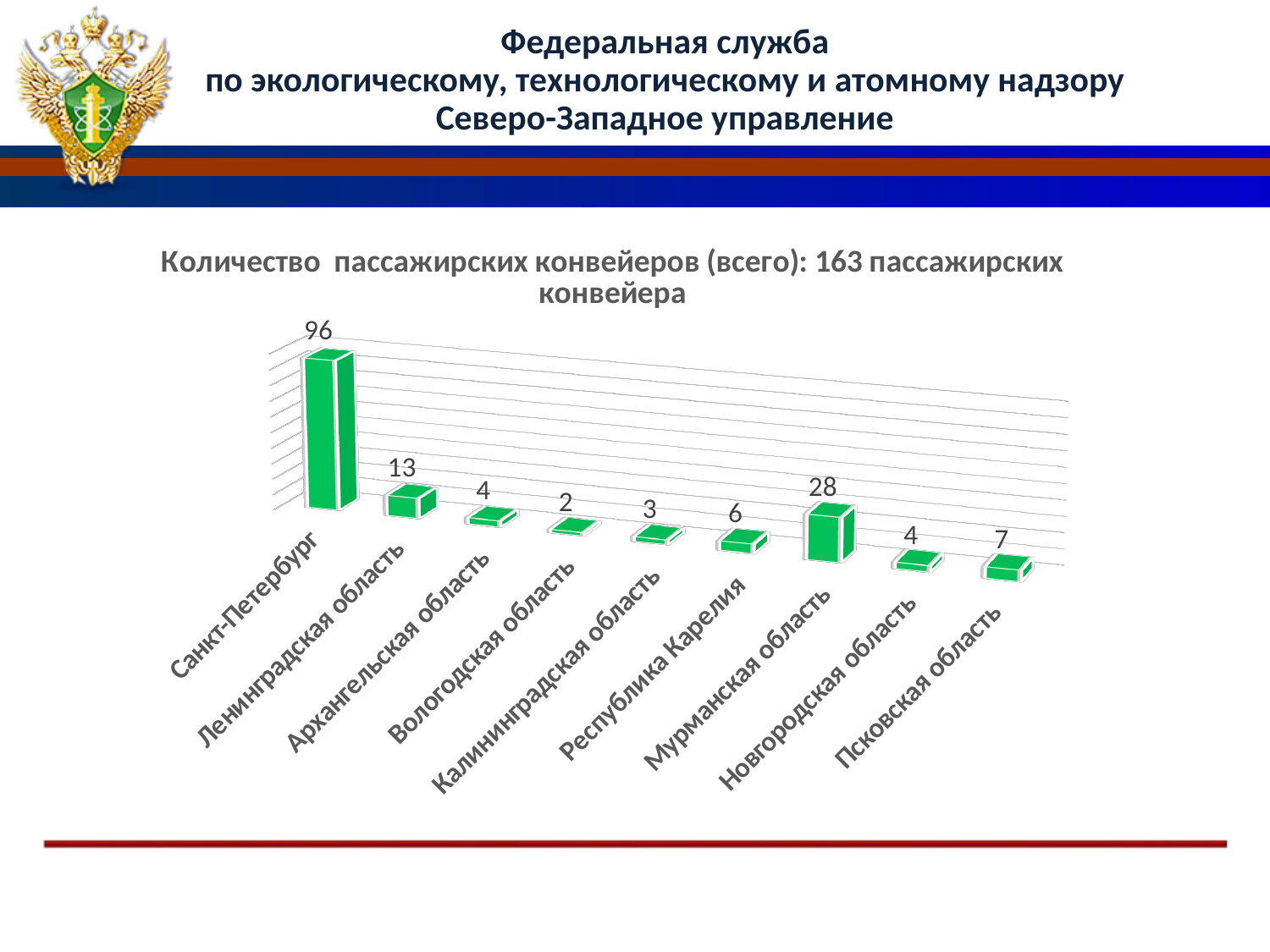
Which category has the lowest value? Вологодская область What is the difference between the values for Ленинградская область and Республика Карелия? 7 What is the value for Псковская область? 7 What is the value for Санкт-Петербург? 96 What is the difference between the values for Санкт-Петербург and Мурманская область? 68 What is the value for Ленинградская область? 13 What kind of chart is shown on the slide? bar chart Which is larger, the value for Республика Карелия or the value for Псковская область? Псковская область How many categories are shown in the chart? 9 What is the value for Мурманская область? 28 What total number of passenger conveyors is stated in the chart title? 163 Which category has the highest value? Санкт-Петербург